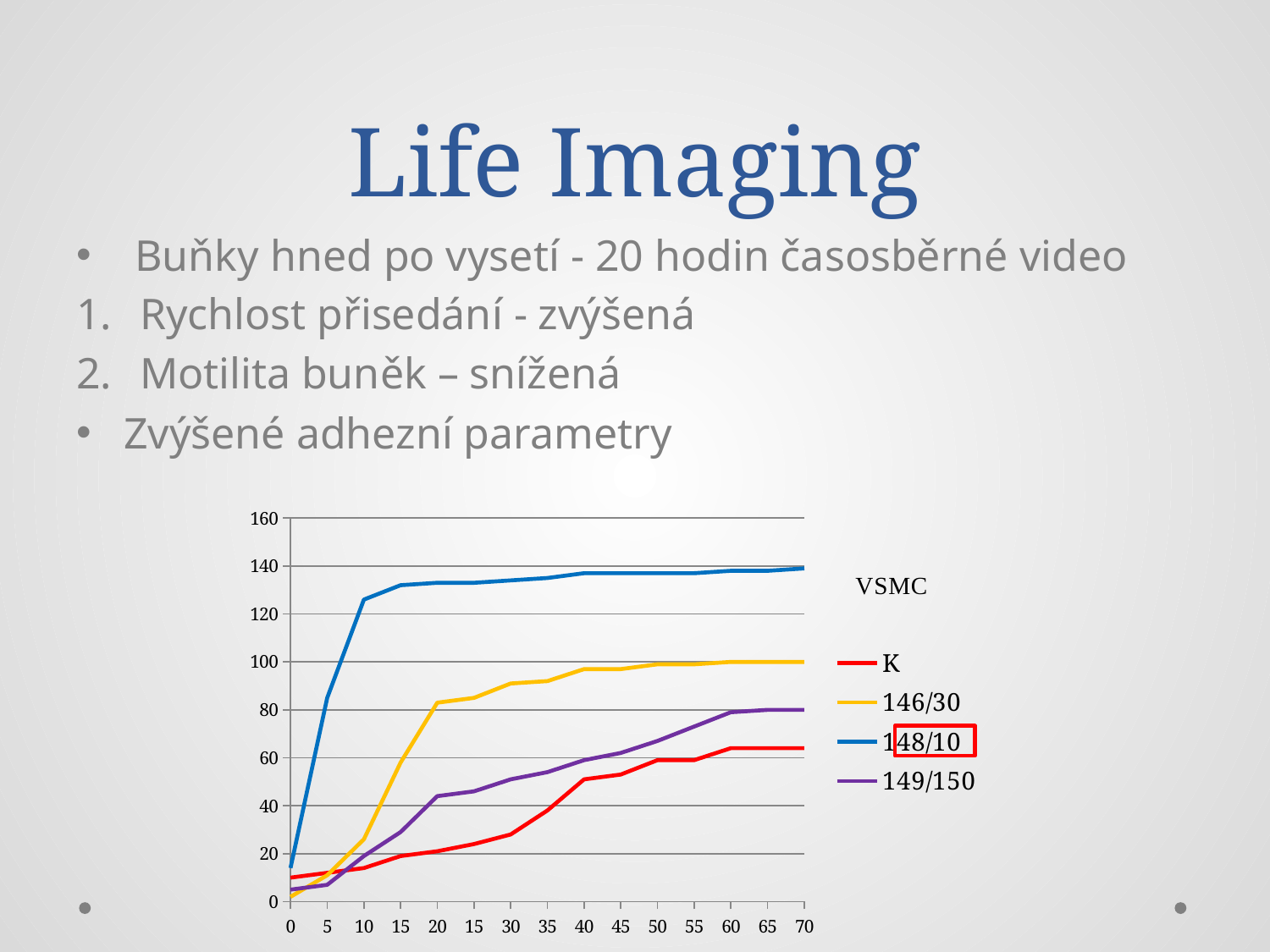
How many points are marked along the x axis of the chart? 15 What colour is the line for the K series? red Which series has the highest value at x = 70? 148/10 What kind of chart is shown on the slide? line chart Is the value of the 148/10 series at x = 70 greater or less than 120? greater What title is shown above the chart legend? VSMC Which series has the lowest value at x = 70? K Is the value of the 148/10 series at x = 10 greater or less than 100? greater Which series has the larger value at x = 40, 146/30 or 149/150? 146/30 How many series does the chart legend list? 4 Is the value of the K series at x = 70 greater or less than 80? less Do the values of the 148/10 series rise or fall along the x axis? rise